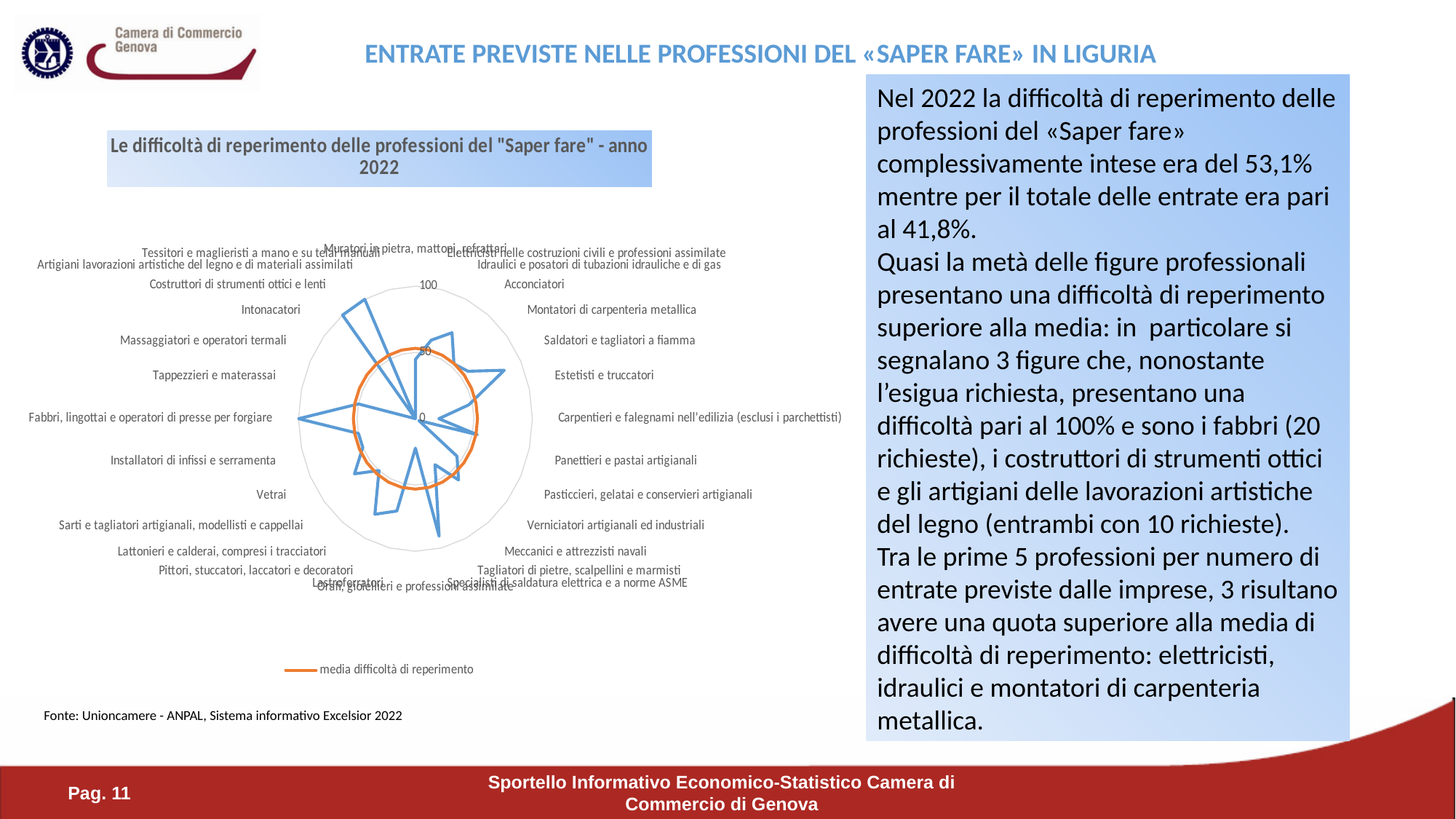
Is the value for Carpentieri e falegnami nell'edilizia (esclusi i parchettisti) greater or less than 50? less How many series does the chart legend list? 1 Which is larger, the value for Fabbri, lingottai e operatori di presse per forgiare or the value for Vetrai? Fabbri, lingottai e operatori di presse per forgiare Is the value for Fabbri, lingottai e operatori di presse per forgiare greater or less than 50? greater What entry does the chart legend list? media difficoltà di reperimento What kind of chart is shown on the slide? radar chart What is the highest value shown on the chart's radial axis? 100 Is the value for Costruttori di strumenti ottici e lenti greater or less than 50? greater What is the title of the chart? Le difficoltà di reperimento delle professioni del "Saper fare" - anno 2022